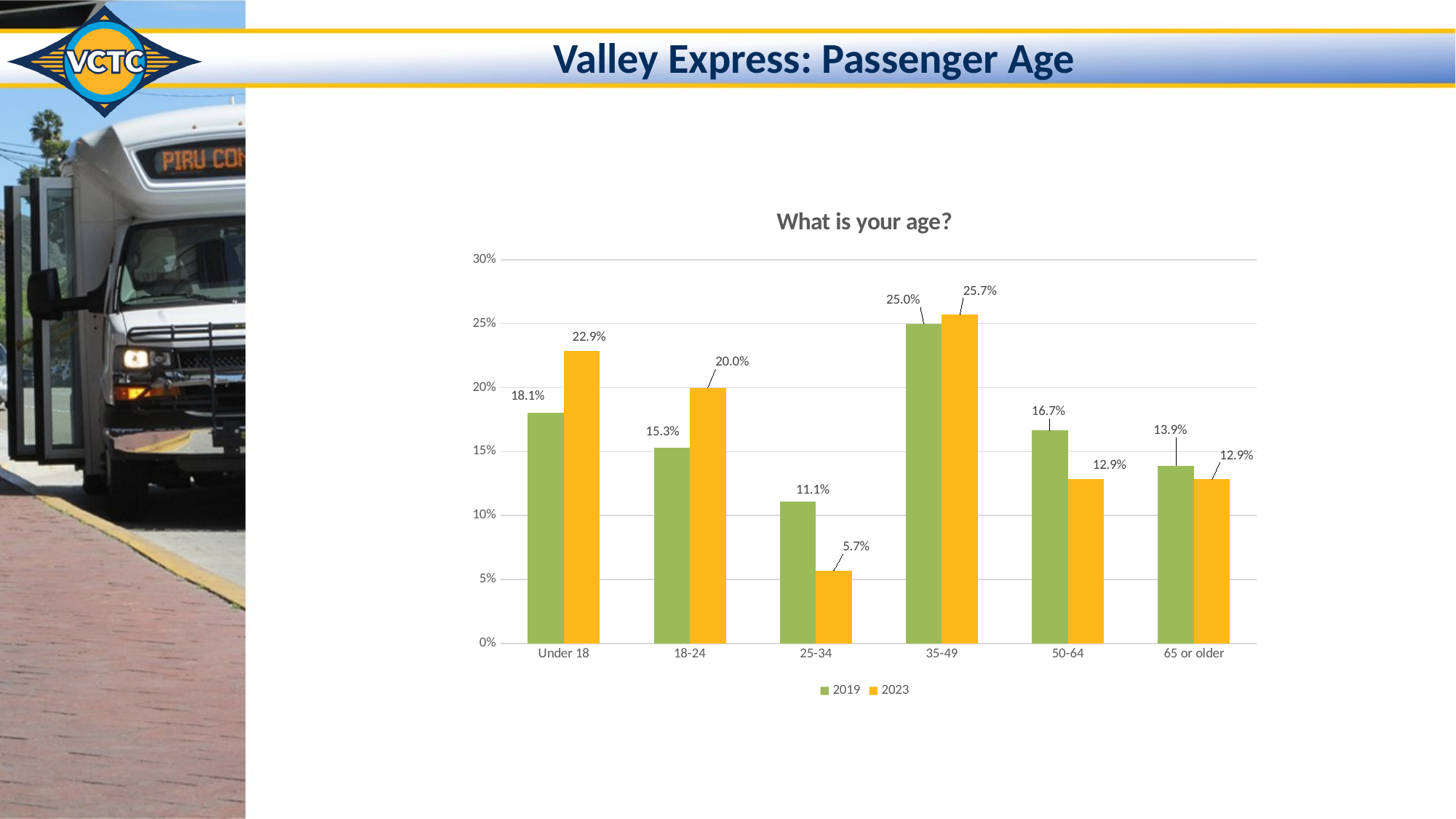
What is the title of the chart? What is your age? What is the 2023 value for the 25-34 age group? 5.7% How many series does the legend list? 2 What kind of chart is shown on the slide? Bar chart Which age group has the highest 2023 value? 35-49 What is the difference between the 2023 and 2019 values for the Under 18 age group? 4.8% What is the 2023 value for the 18-24 age group? 20.0% How many age groups are shown on the x axis? 6 Which colour represents the 2023 series? Orange What is the 2019 value for the Under 18 age group? 18.1% Which is larger for the 50-64 age group, the 2019 value or the 2023 value? 2019 Which age group has the lowest 2019 value? 25-34